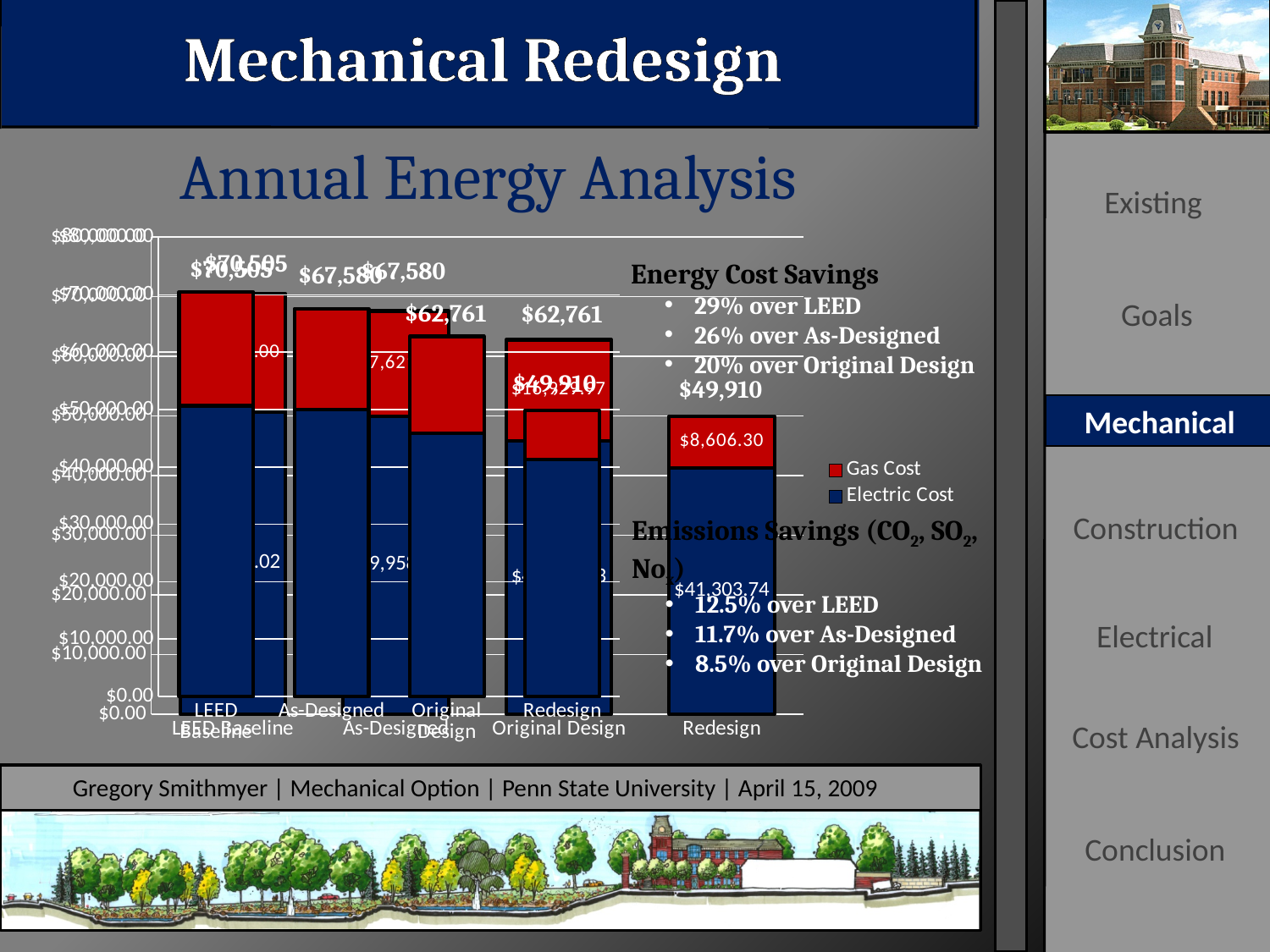
Do the total annual energy costs rise or fall from left to right across the categories in the Annual Energy Analysis chart? Fall How many series does the legend of the Annual Energy Analysis chart list? 2 What is the difference between the LEED Baseline total and the Redesign total in the Annual Energy Analysis chart? $20,595 Which category has the lowest total annual energy cost in the Annual Energy Analysis chart? Redesign What is the Electric Cost for Redesign in the Annual Energy Analysis chart? $41,303.74 How many design categories are shown on the x axis of the Annual Energy Analysis chart? 4 What is the total annual energy cost for Redesign in the Annual Energy Analysis chart? $49,910 Which colour represents Gas Cost in the Annual Energy Analysis chart legend? Red What is the Gas Cost for Redesign in the Annual Energy Analysis chart? $8,606.30 Which category has the highest total annual energy cost in the Annual Energy Analysis chart? LEED Baseline What kind of chart is the Annual Energy Analysis chart? Stacked bar chart What is the total annual energy cost for LEED Baseline in the Annual Energy Analysis chart? $70,505